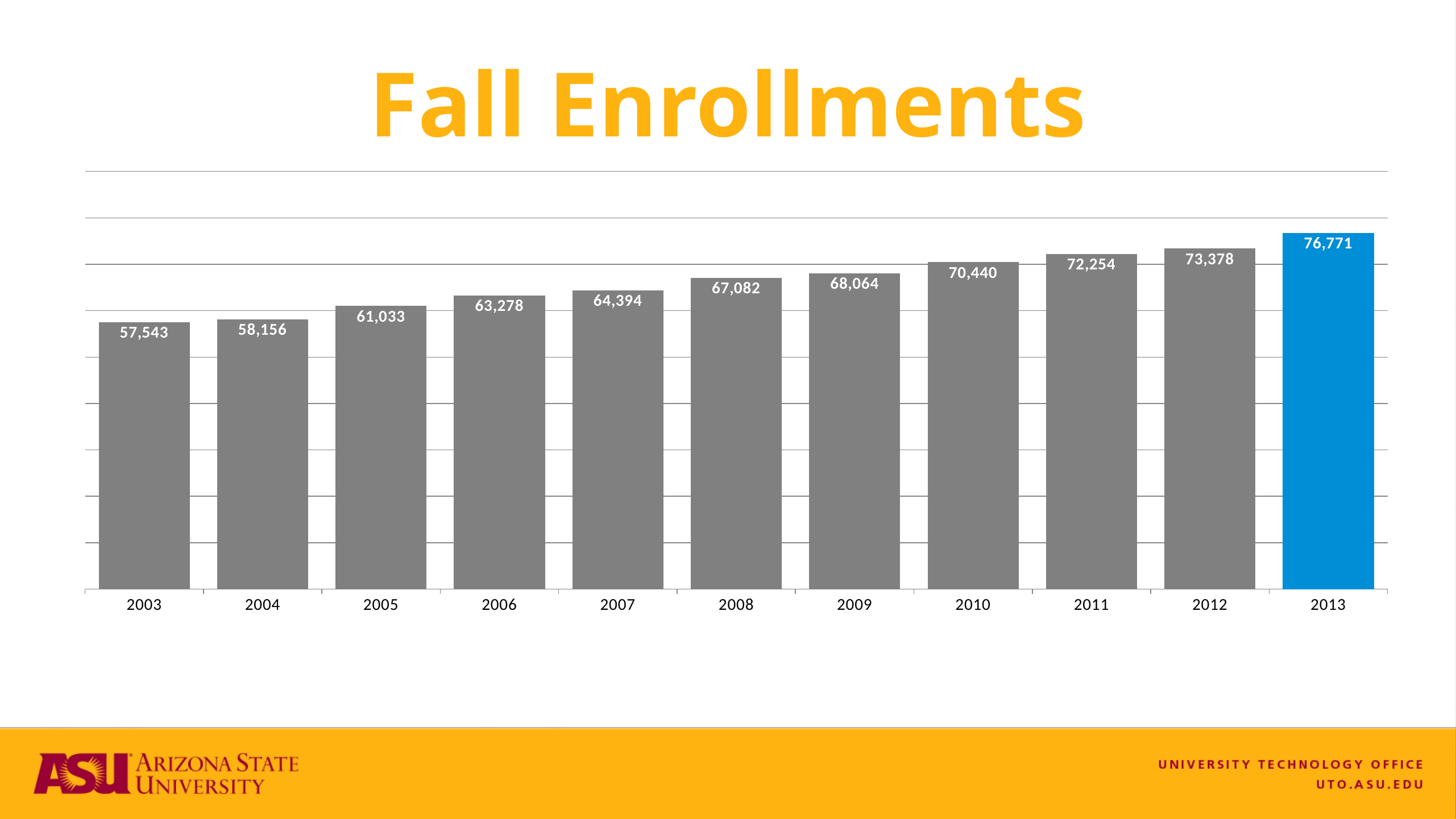
What is the fall enrollment value for 2003? 57,543 Do fall enrollments rise or fall from 2003 to 2013? Rise Which year has the lowest fall enrollment? 2003 What is the difference in fall enrollment between 2013 and 2012? 3,393 What is the fall enrollment value for 2008? 67,082 What is the fall enrollment value for 2013? 76,771 How many years are shown on the x axis of the chart? 11 What is the difference in fall enrollment between 2004 and 2003? 613 Which year's bar is coloured blue instead of grey? 2013 What kind of chart is shown on the slide? Bar chart Which year has a larger fall enrollment, 2007 or 2010? 2010 Which year has the highest fall enrollment? 2013